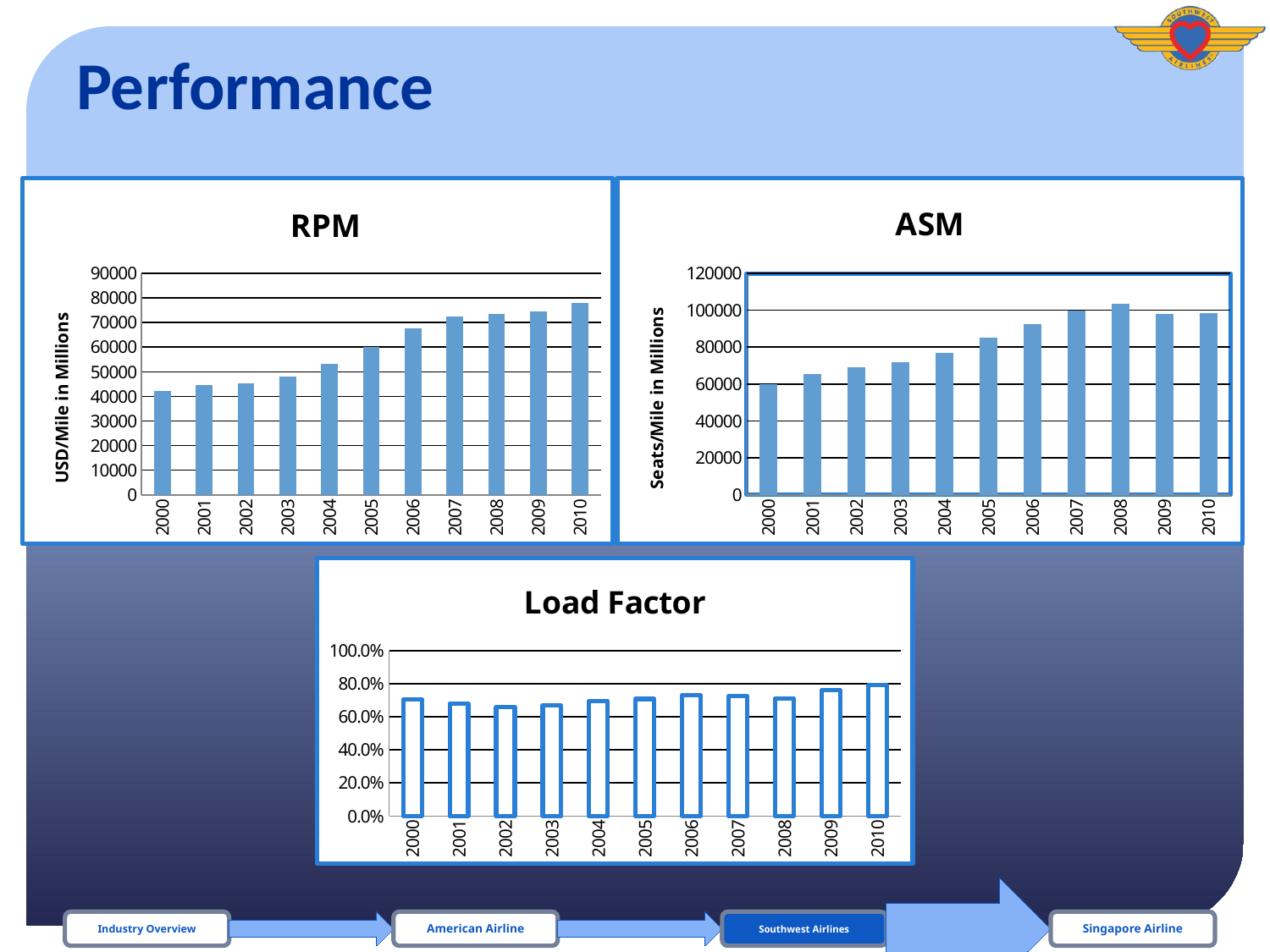
On the RPM chart, which year has the lowest value? 2000 How many years are shown on the RPM chart? 11 On the Load Factor chart, which year has the highest value? 2010 On the Load Factor chart, is the value for 2002 greater or less than 60.0%? greater On the RPM chart, is the value for 2010 greater or less than 70000? greater On the ASM chart, which year has the highest value? 2008 On the RPM chart, is the value for 2000 greater or less than 50000? less What is the y-axis label of the ASM chart? Seats/Mile in Millions On the RPM chart, which year has the highest value? 2010 On the ASM chart, which year has the lowest value? 2000 On the ASM chart, which is larger, the value for 2008 or the value for 2009? 2008